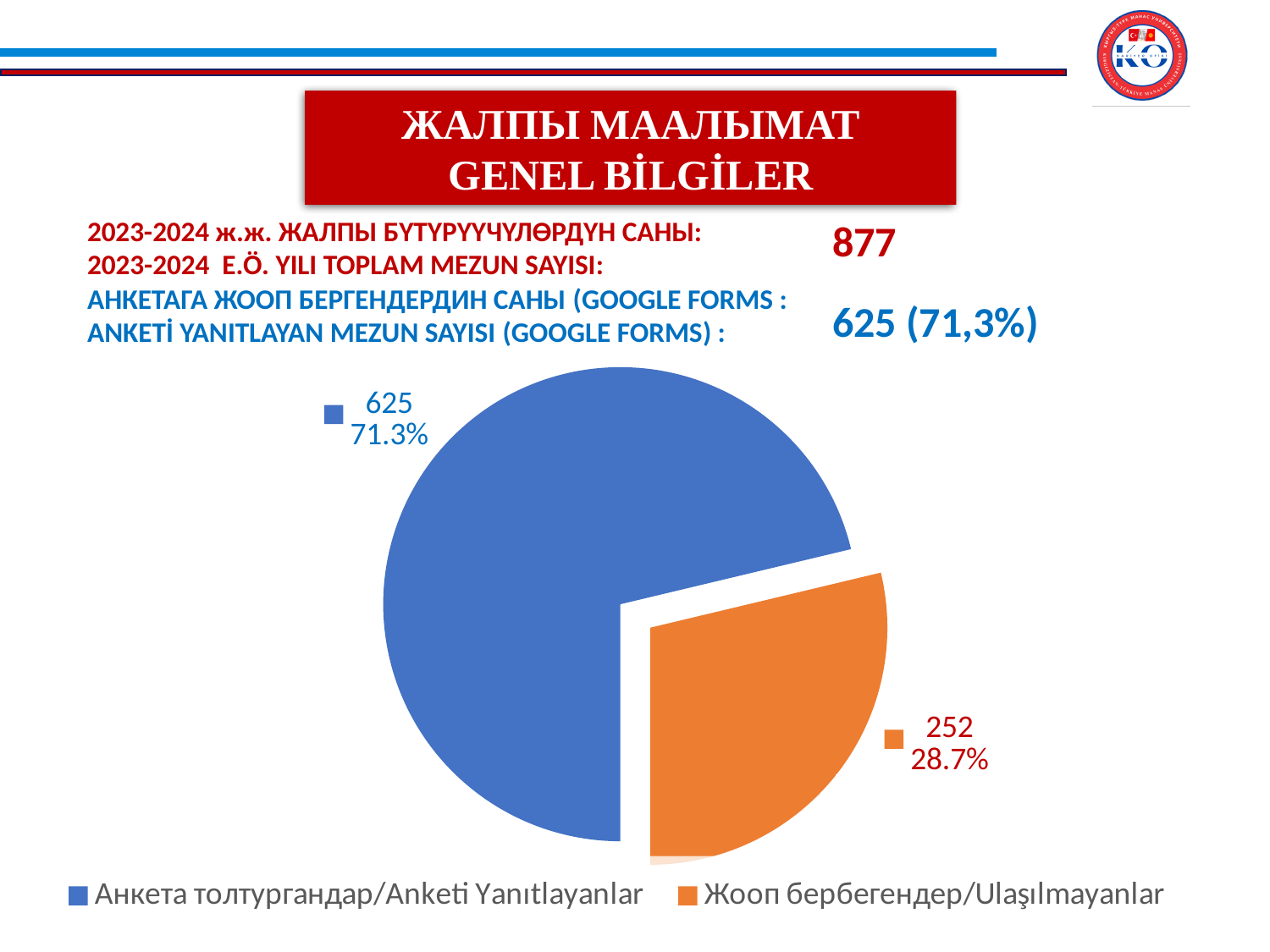
What is the value shown for the slice 'Жооп бербегендер/Ulaşılmayanlar'? 252 How many slices does the pie chart have? 2 What share of the pie does the 'Жооп бербегендер/Ulaşılmayanlar' slice represent? 28.7% What share of the pie does the 'Анкета толтургандар/Anketi Yanıtlayanlar' slice represent? 71.3% What is the difference between the values of the two slices in the pie chart? 373 How many entries does the legend of the pie chart list? 2 What colour is the 'Жооп бербегендер/Ulaşılmayanlar' slice in the pie chart? orange What is the value shown for the slice 'Анкета толтургандар/Anketi Yanıtlayanlar'? 625 Which slice of the pie chart is the smallest? Жооп бербегендер/Ulaşılmayanlar What kind of chart is shown on the slide? pie chart What is the total of the two slice values in the pie chart? 877 Which slice of the pie chart is the largest? Анкета толтургандар/Anketi Yanıtlayanlar